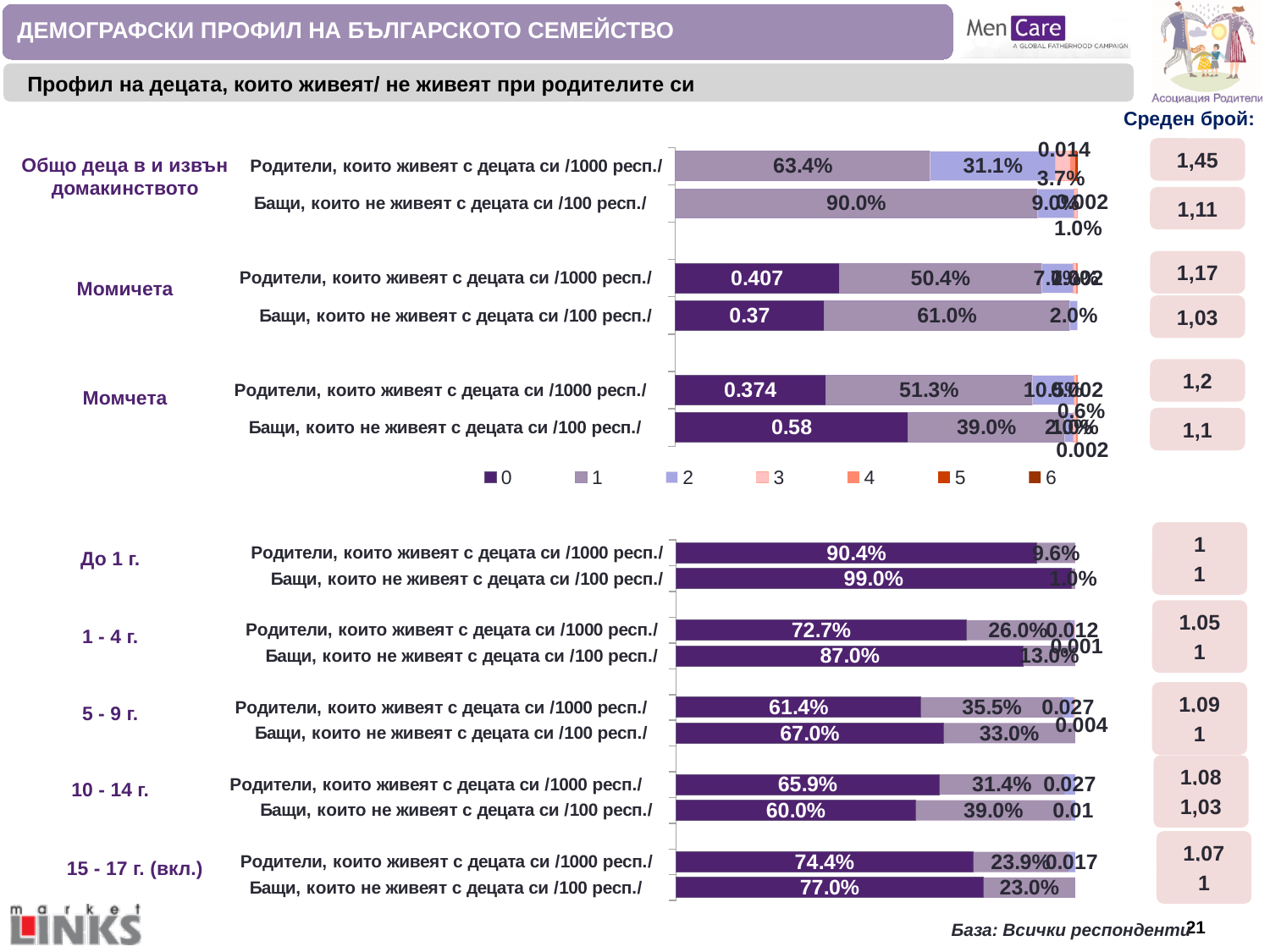
What is the subtitle of the slide above the charts? Профил на децата, които живеят/ не живеят при родителите си In the top chart, what is the value of the second segment for 'Бащи, които не живеят с децата си /100 респ./' under 'Момичета'? 61.0% How many series does the legend of the top chart list? 7 In the top chart, what is the value of the first segment for 'Родители, които живеят с децата си /1000 респ./' under 'Общо деца в и извън домакинството'? 63.4% How many age-group categories does the bottom chart show? 5 In the top chart, what is the value of the first segment for 'Бащи, които не живеят с децата си /100 респ./' under 'Общо деца в и извън домакинството'? 90.0% What kind of chart is the bottom chart? Stacked horizontal bar chart In the bottom chart, what is the difference between the first segments of 'Родители, които живеят с децата си /1000 респ./' (90.4%) and 'Бащи, които не живеят с децата си /100 респ./' (99.0%) under 'До 1 г.'? 8.6% In the top chart, what is the value of the first segment for 'Бащи, които не живеят с децата си /100 респ./' under 'Момчета'? 0.58 In the bottom chart, which is larger: the first segment for 'Родители, които живеят с децата си /1000 респ./' under '10 - 14 г.' or the first segment for 'Бащи, които не живеят с децата си /100 респ./' under '10 - 14 г.'? Родители, които живеят с децата си /1000 респ./ (65.9%) In the bottom chart, what is the value of the second segment for 'Родители, които живеят с децата си /1000 респ./' under '5 - 9 г.'? 35.5% In the bottom chart, what is the value of the first segment for 'Бащи, които не живеят с децата си /100 респ./' under 'До 1 г.'? 99.0%